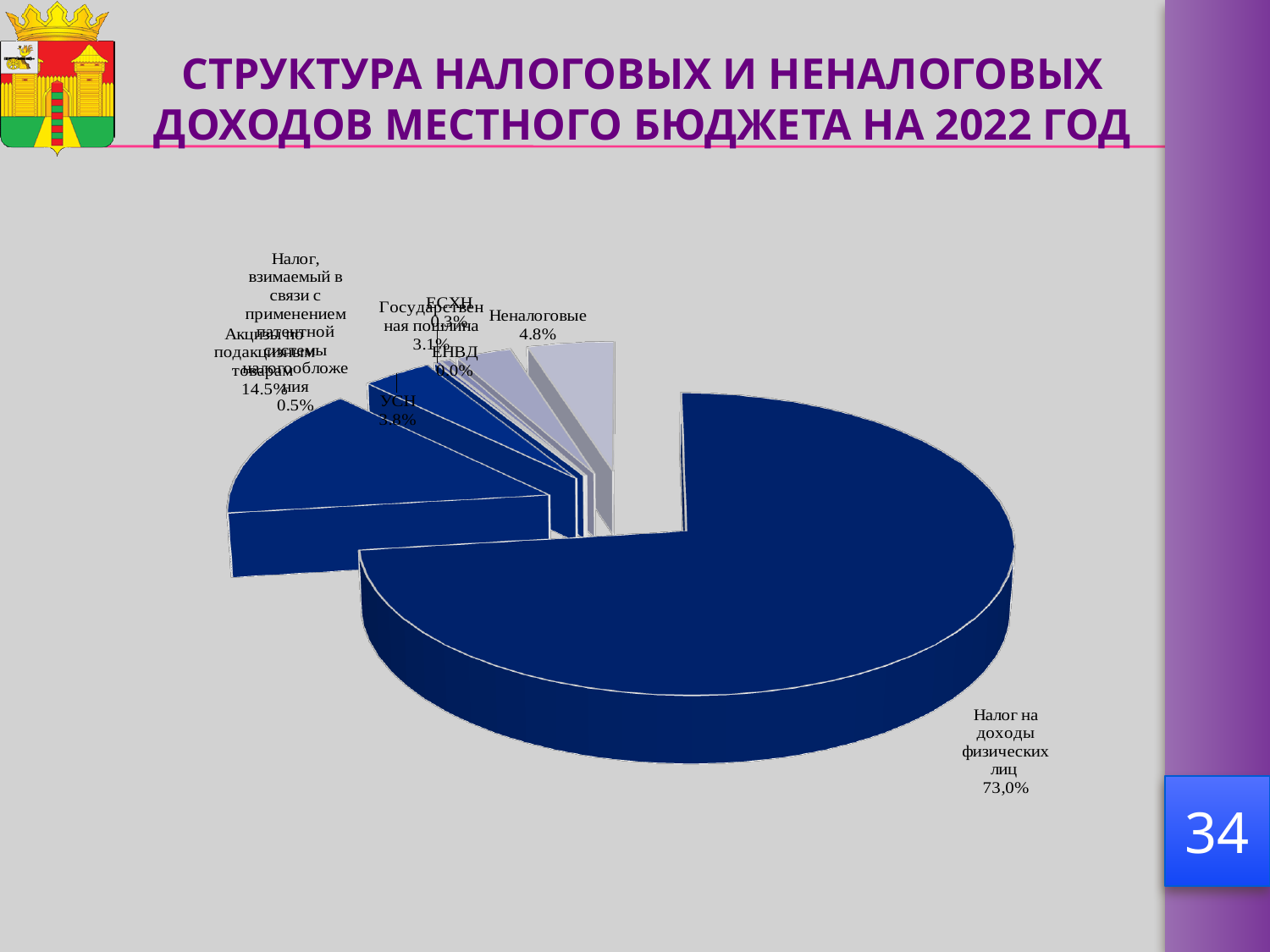
What share of the pie does "Налог на доходы физических лиц" have? 73,0% What is the title of the slide containing the chart? СТРУКТУРА НАЛОГОВЫХ И НЕНАЛОГОВЫХ ДОХОДОВ МЕСТНОГО БЮДЖЕТА НА 2022 ГОД How many slices does the pie chart have? 8 What is the value shown for "ЕНВД"? 0.0% Which is larger, the share for "Акцизы по подакцизным товарам" or for "Неналоговые"? Акцизы по подакцизным товарам What is the difference between the shares of "Акцизы по подакцизным товарам" and "Неналоговые"? 9.7% Which category has the smallest value in the chart? ЕНВД What kind of chart is shown on the slide? pie chart What is the value shown for "Государственная пошлина"? 3.1% Which category has the largest slice of the pie? Налог на доходы физических лиц What is the value shown for "Неналоговые"? 4.8% What is the value shown for "Акцизы по подакцизным товарам"? 14.5%